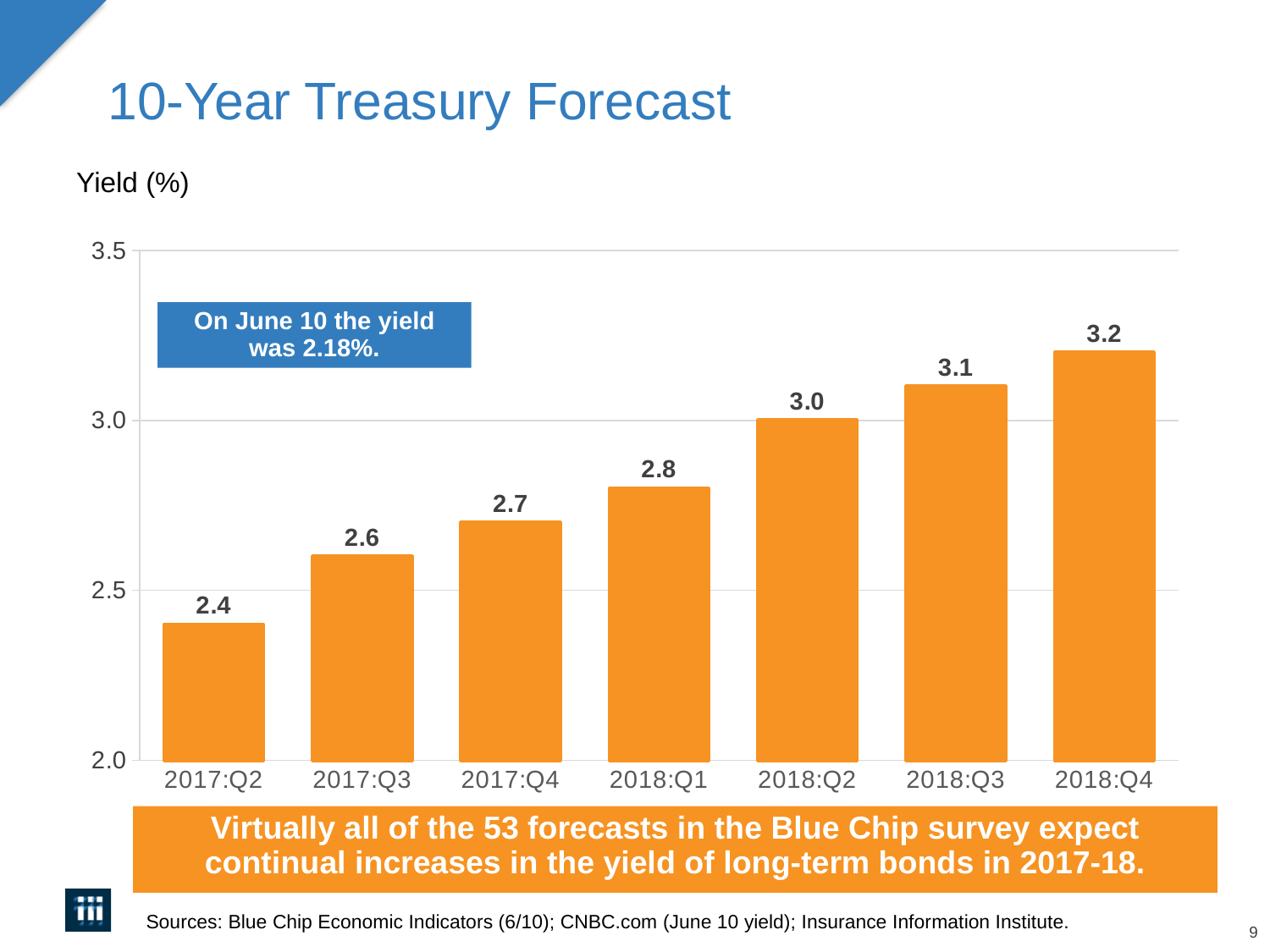
Which quarter has the highest forecast yield? 2018:Q4 Do the forecast yields rise or fall from 2017:Q2 to 2018:Q4? Rise Is the forecast yield for 2018:Q3 greater or less than 3.0? greater What is the forecast 10-year Treasury yield for 2017:Q2? 2.4 Which is larger, the forecast yield for 2018:Q1 or 2017:Q3? 2018:Q1 Which quarter has the lowest forecast yield? 2017:Q2 What is the forecast yield for 2018:Q2? 3.0 What kind of chart is shown on the slide? Bar chart How many quarters are shown on the chart? 7 What is the forecast yield for 2017:Q4? 2.7 According to the callout box on the chart, what was the yield on June 10? 2.18% What is the difference between the forecast yield for 2018:Q4 and 2017:Q2? 0.8